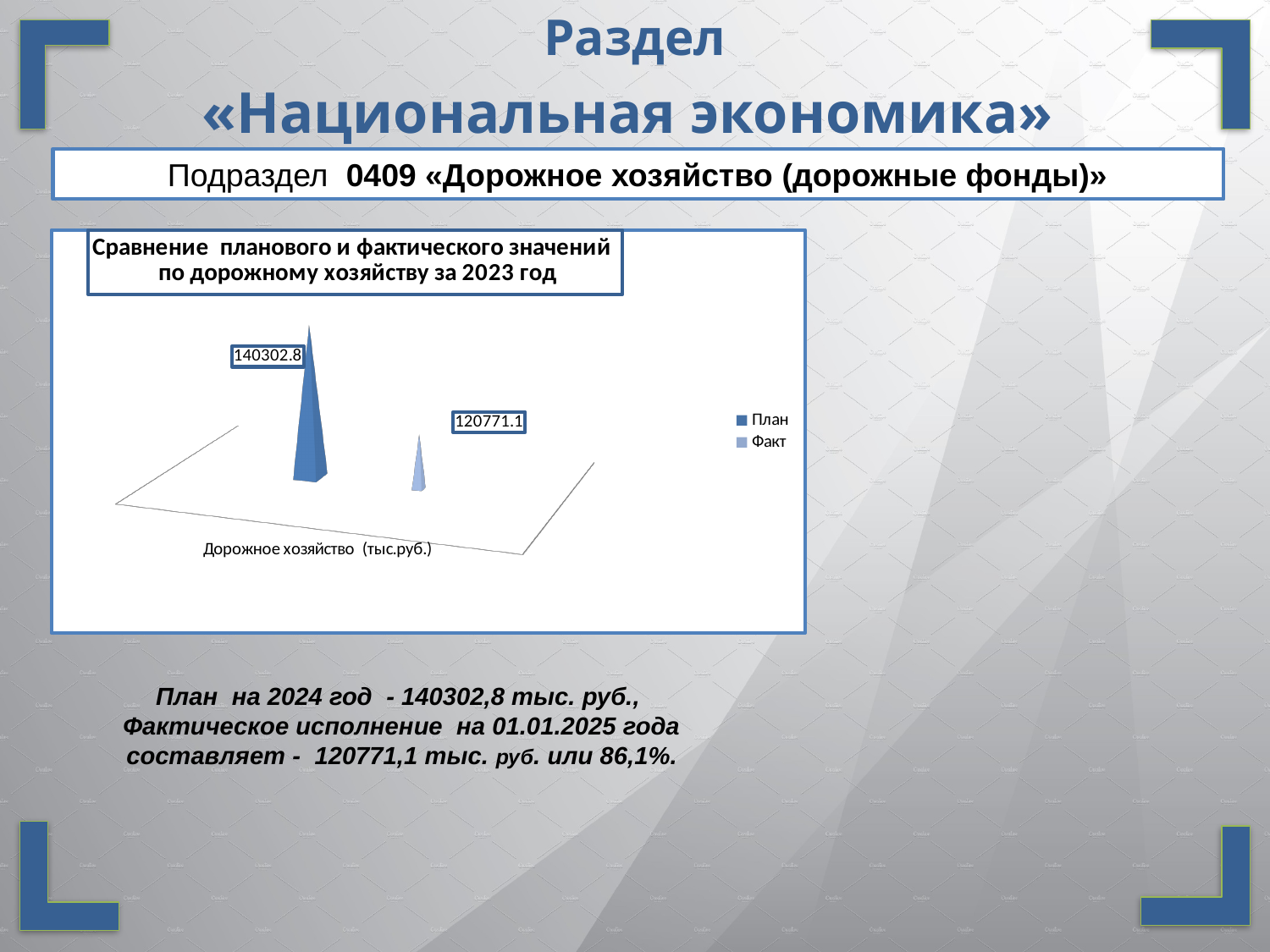
What is the category label shown on the chart's x axis? Дорожное хозяйство (тыс.руб.) Which series has the highest value in the chart? План Which series has the lowest value in the chart? Факт What is the title of the chart? Сравнение планового и фактического значений по дорожному хозяйству за 2023 год What is the value of the Факт series in the chart? 120771.1 How many series does the chart legend list? 2 Which series has the higher value, План or Факт? План What is the difference between the План and Факт values? 19531.7 What kind of chart is shown on the slide? Bar chart What is the value of the План series in the chart? 140302.8 How many categories are shown on the chart's x axis? 1